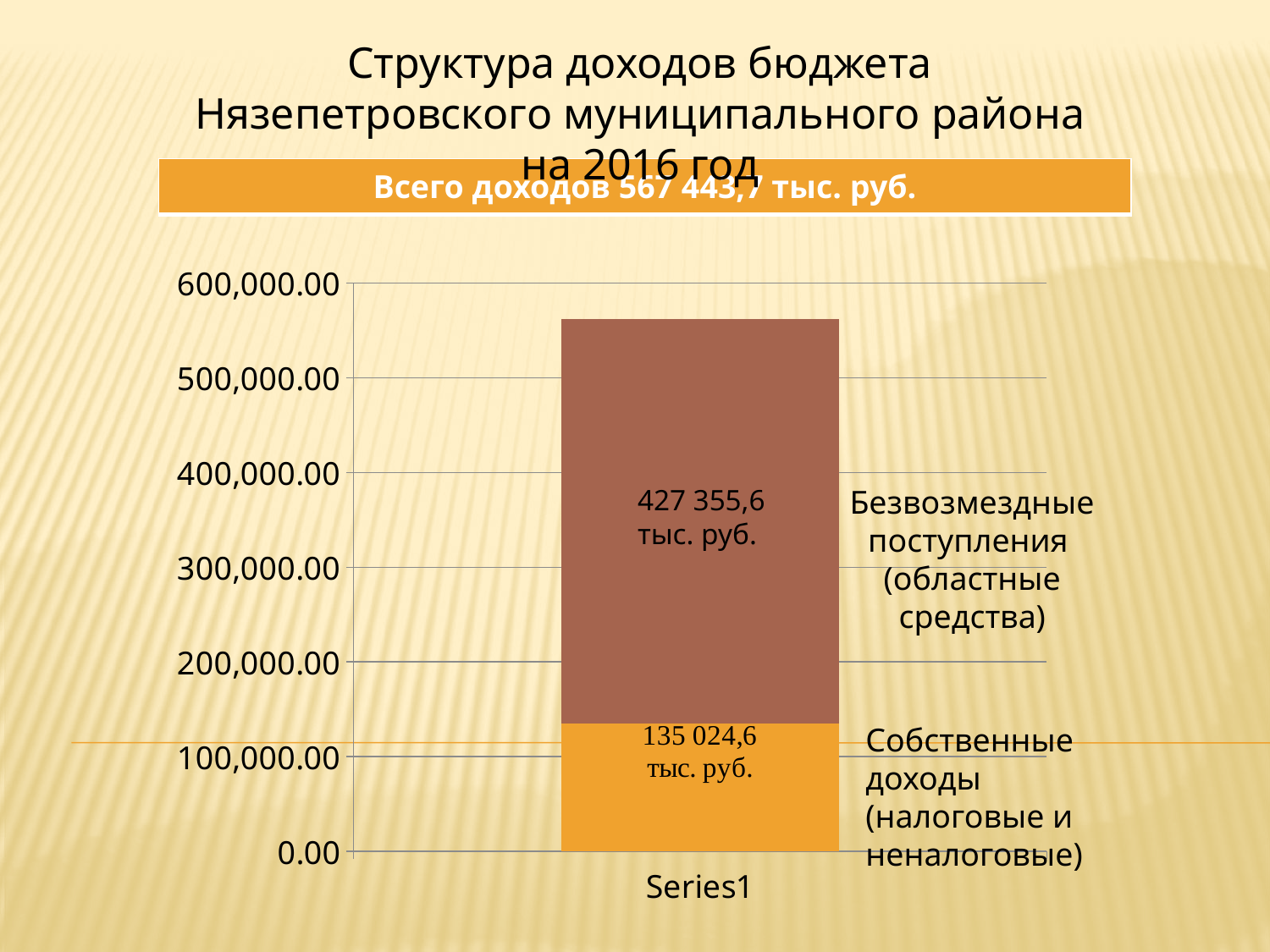
What is the value of the Собственные доходы (налоговые и неналоговые) segment? 135 024,6 тыс. руб. What is the value of the Безвозмездные поступления (областные средства) segment? 427 355,6 тыс. руб. What is the chart's title? Всего доходов 567 443,7 тыс. руб. Is the total height of the stacked bar greater or less than 500,000.00? greater Is the value for Собственные доходы greater or less than 200,000.00? less What is the total of the stacked bar according to the chart title? 567 443,7 тыс. руб. How many bars are plotted in the chart? 1 What is the difference between the Безвозмездные поступления and Собственные доходы values? 292 331,0 тыс. руб. Which segment of the bar is the smallest? Собственные доходы (налоговые и неналоговые) Which segment is larger: Безвозмездные поступления or Собственные доходы? Безвозмездные поступления What colour is the Собственные доходы segment of the bar? orange What kind of chart is shown on the slide? stacked bar chart